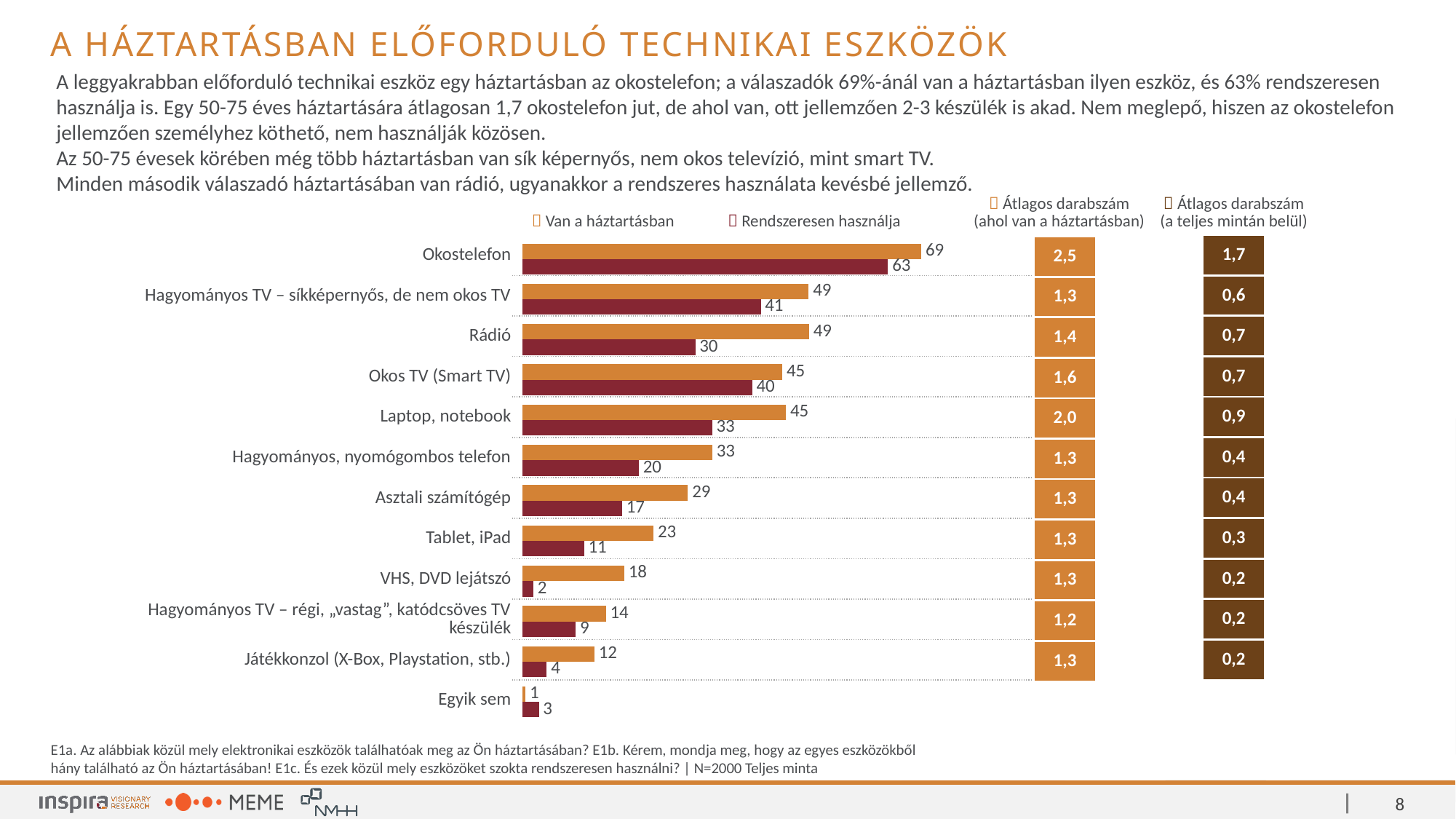
What is the 'Rendszeresen használja' value for VHS, DVD lejátszó? 2 What is the 'Átlagos darabszám (a teljes mintán belül)' value for Okostelefon? 1,7 How many series does the bar chart legend list? 2 How many categories are shown in the bar chart? 12 Which category has the lowest 'Rendszeresen használja' value? VHS, DVD lejátszó What kind of chart is shown on the slide? Bar chart What is the 'Rendszeresen használja' value for Rádió? 30 Which category has the highest 'Van a háztartásban' value? Okostelefon What is the difference between the 'Van a háztartásban' and 'Rendszeresen használja' values for Rádió? 19 What is the 'Van a háztartásban' value for Okostelefon? 69 What is the 'Átlagos darabszám (ahol van a háztartásban)' value for Laptop, notebook? 2,0 Which is larger: the 'Rendszeresen használja' value for Okos TV (Smart TV) or for Laptop, notebook? Okos TV (Smart TV)